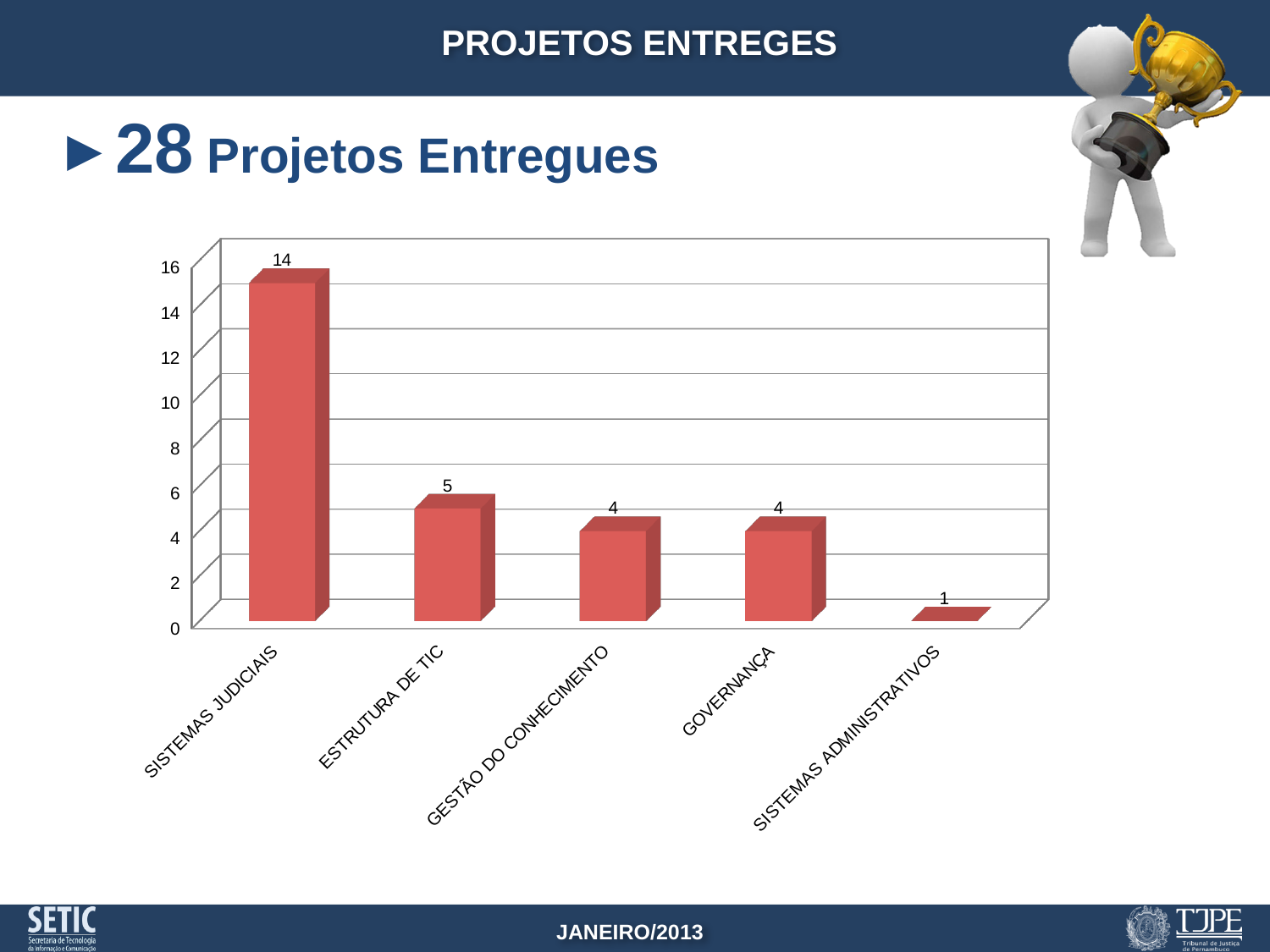
What is the value for GESTÃO DO CONHECIMENTO? 4 Which is larger, the value for ESTRUTURA DE TIC or the value for GOVERNANÇA? ESTRUTURA DE TIC How many categories are shown on the x axis? 5 What is the total of all the bar values in the chart? 28 What is the value for SISTEMAS ADMINISTRATIVOS? 1 Which category has the lowest value? SISTEMAS ADMINISTRATIVOS Is the value for SISTEMAS JUDICIAIS greater or less than 10? greater What kind of chart is shown on the slide? bar chart Which category has the highest value? SISTEMAS JUDICIAIS What is the value for SISTEMAS JUDICIAIS? 14 What is the value for ESTRUTURA DE TIC? 5 What is the difference between the values for SISTEMAS JUDICIAIS and ESTRUTURA DE TIC? 9